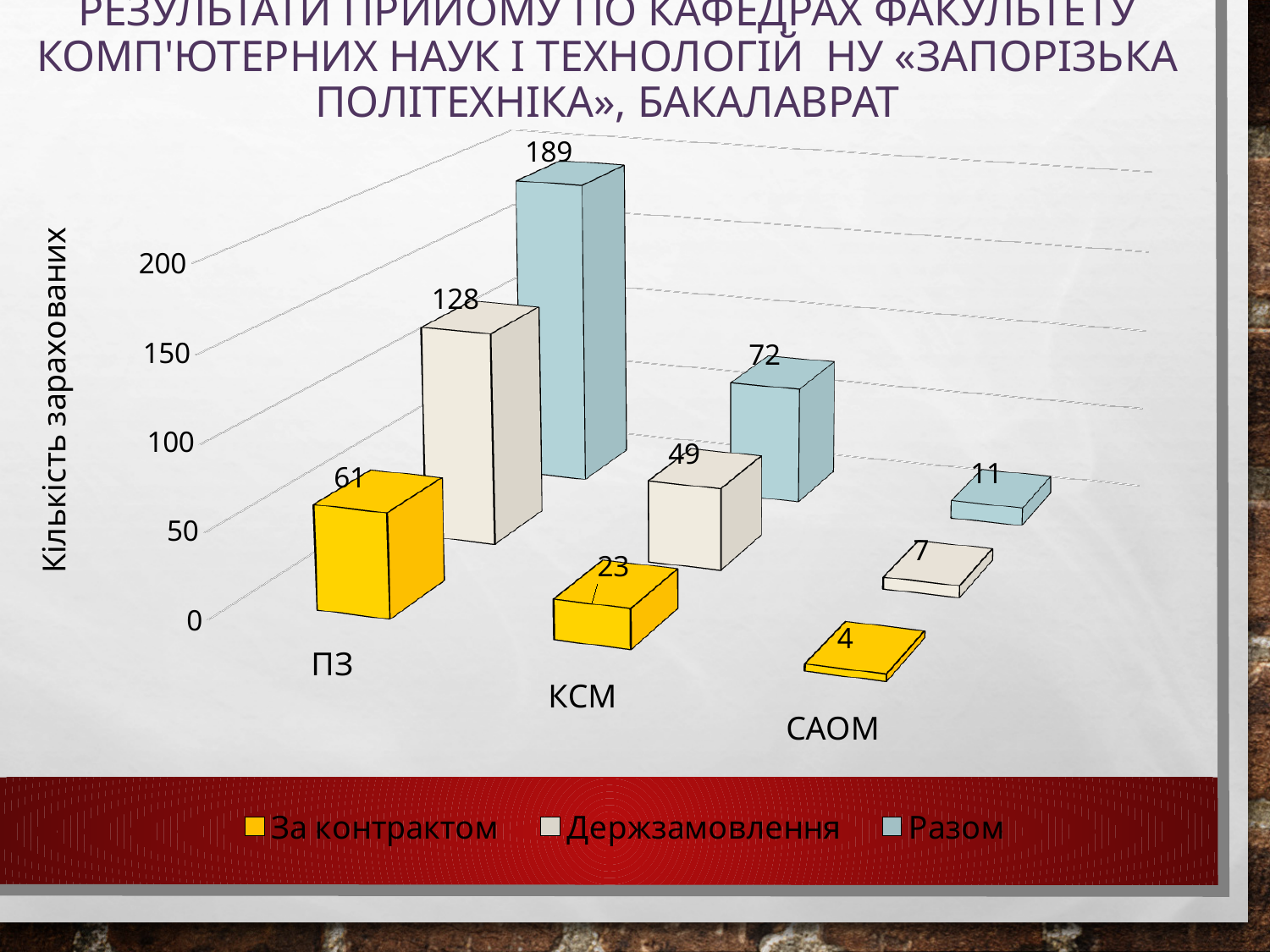
What is the value of Разом for ПЗ? 189 What kind of chart is shown on the slide? Bar chart What is the difference between Держзамовлення for ПЗ and Держзамовлення for КСМ? 79 What is the label of the vertical axis? Кількість зарахованих Do the Разом values rise or fall from ПЗ to САОМ along the x axis? Fall What is the value of Держзамовлення for КСМ? 49 Which is larger: За контрактом for КСМ or Держзамовлення for САОМ? За контрактом for КСМ What is the value of За контрактом for САОМ? 4 How many series does the legend list? 3 Which department has the lowest За контрактом value? САОМ How many departments (categories) are shown on the x axis? 3 Which department has the highest Разом value? ПЗ